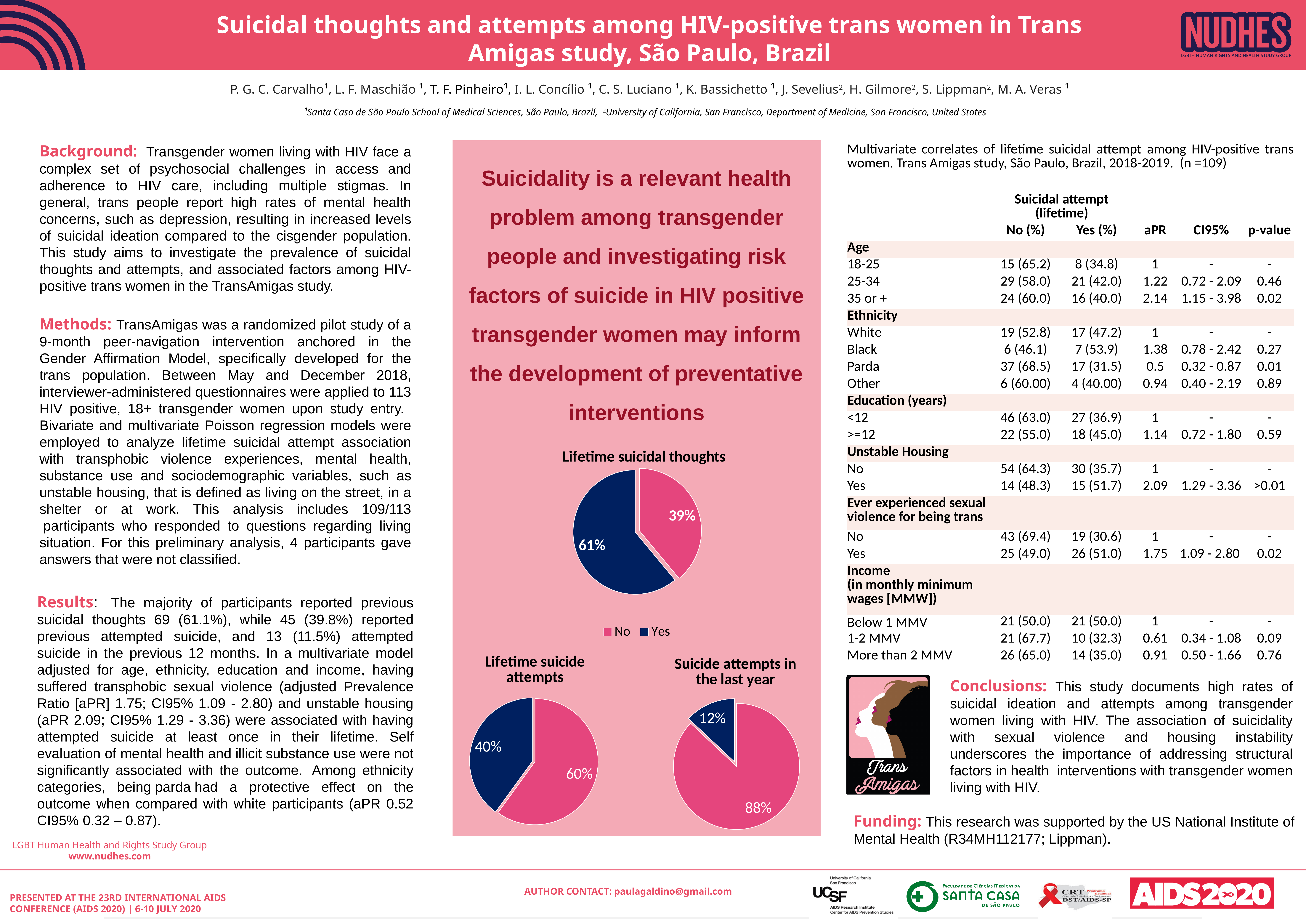
In the 'Lifetime suicide attempts' chart, what percentage of participants answered Yes? 40% In the 'Lifetime suicide attempts' chart, which slice is larger, No or Yes? No In the 'Lifetime suicidal thoughts' chart, what is the difference between the Yes and No percentages? 22% In the 'Suicide attempts in the last year' chart, what percentage of participants answered Yes? 12% What type of chart is used to show 'Lifetime suicide attempts'? Pie chart In the 'Suicide attempts in the last year' chart, what is the difference between the No and Yes percentages? 76% In the 'Lifetime suicidal thoughts' chart, what percentage of participants answered Yes? 61% In the 'Lifetime suicidal thoughts' chart, what percentage of participants answered No? 39% In the 'Suicide attempts in the last year' chart, which slice is the smallest? Yes How many entries does the legend under the 'Lifetime suicidal thoughts' chart list? 2 In the 'Lifetime suicidal thoughts' chart, which slice is the largest? Yes In the 'Suicide attempts in the last year' chart, what percentage of participants answered No? 88%